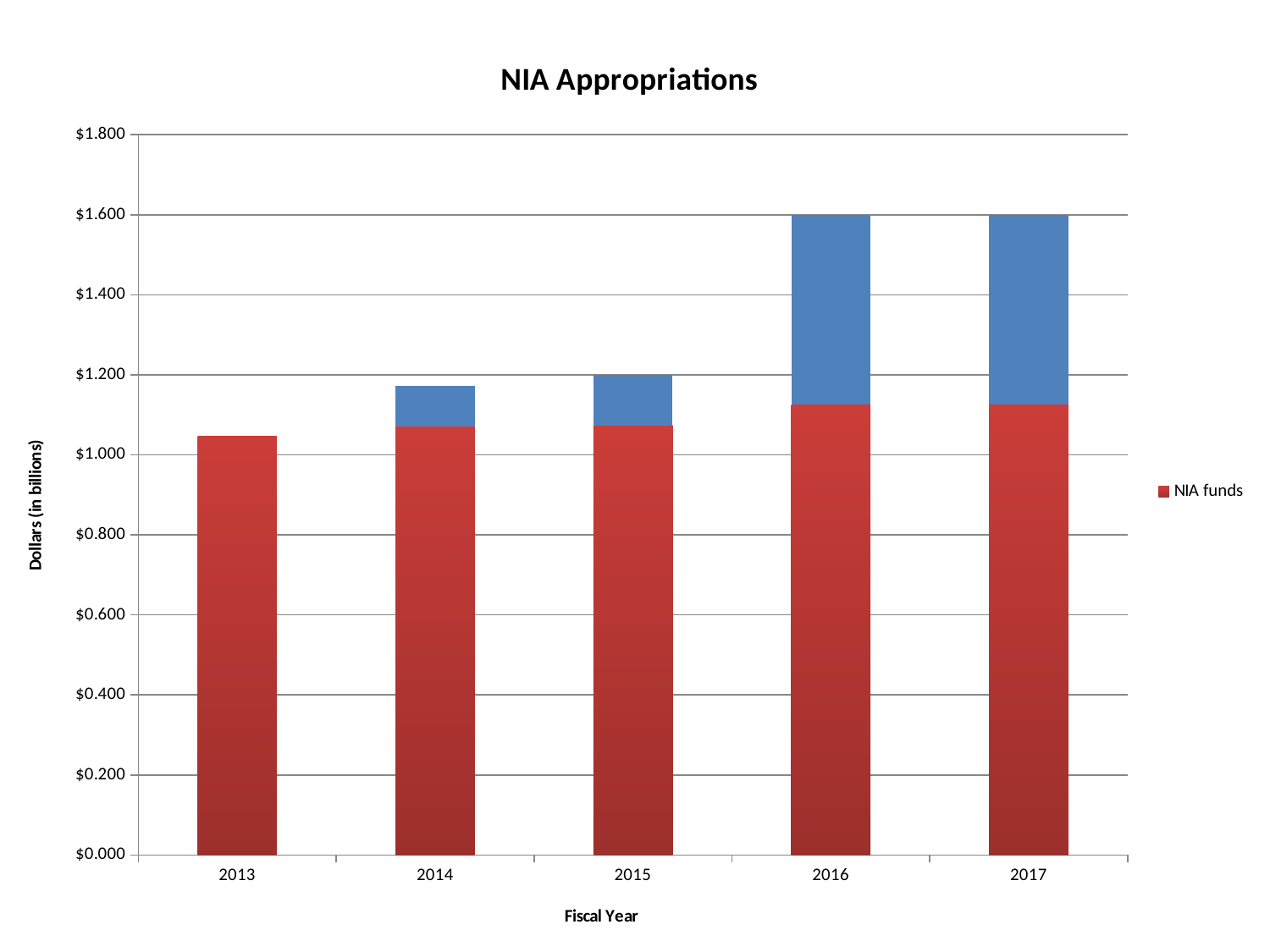
Which fiscal year has the larger total bar, 2013 or 2016? 2016 Is the total bar for 2013 greater or less than $1.000? greater What kind of chart is shown on the slide? bar chart Do the total bar heights generally rise or fall from 2013 to 2017? rise How many series does the legend list? 1 What is the title of the chart? NIA Appropriations Is the red NIA funds portion for 2017 greater or less than $1.000? greater Which fiscal year has the lowest total bar? 2013 How many fiscal years are shown on the x axis? 5 Is the total bar for 2013 greater or less than $1.200? less What is the label on the y axis? Dollars (in billions)